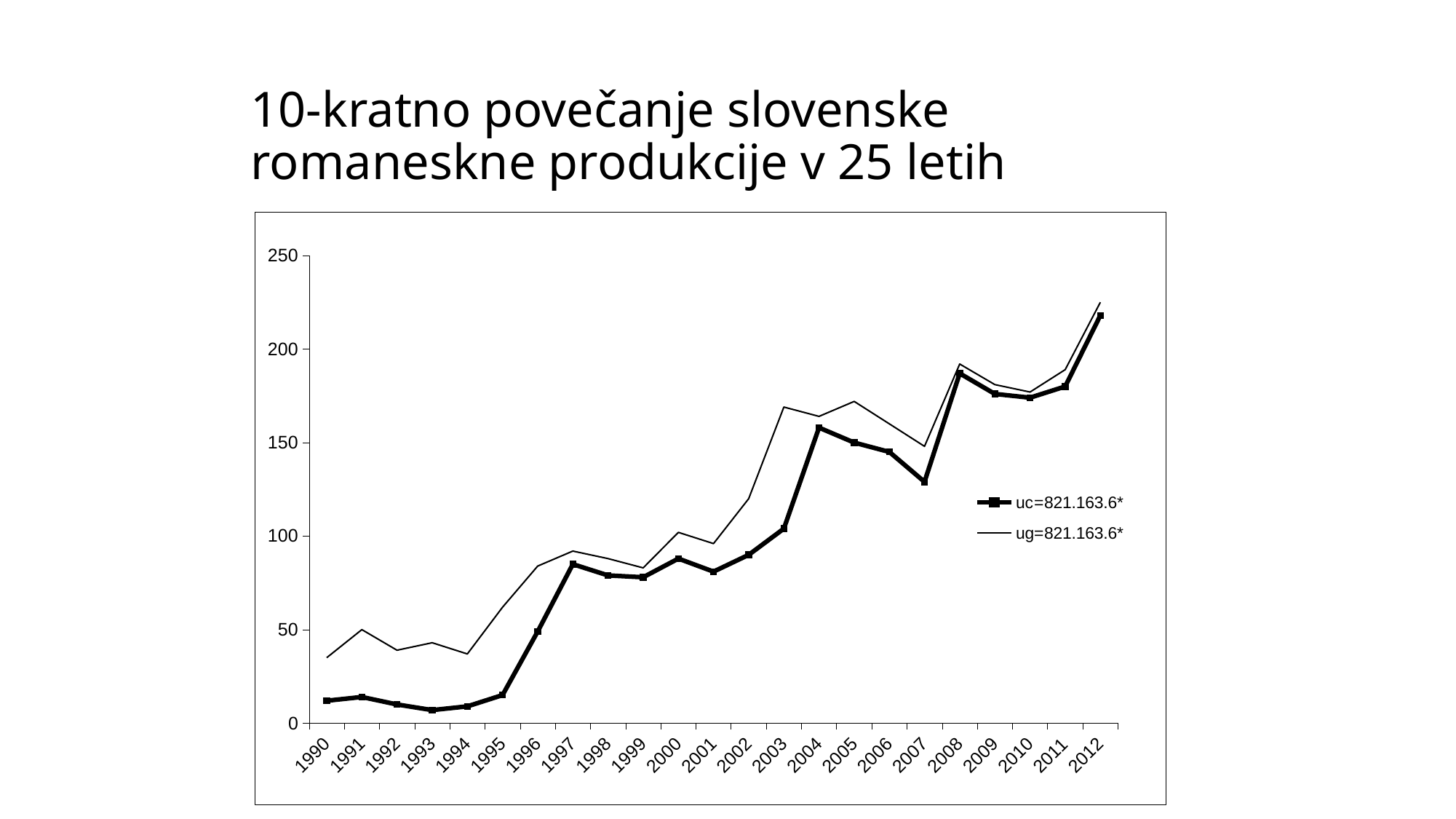
Is the value for uc=821.163.6* in 2007 greater or less than 150? less In which year does the ug=821.163.6* series reach its highest value? 2012 In which year does the uc=821.163.6* series reach its highest value? 2012 In which year does the uc=821.163.6* series reach its lowest value? 1993 Is the value for ug=821.163.6* in 2003 greater or less than 150? greater In 2003, which series has the higher value, uc=821.163.6* or ug=821.163.6*? ug=821.163.6* What kind of chart is shown on the slide? line chart Is the value for ug=821.163.6* in 1990 greater or less than 50? less How many years are plotted along the x axis? 23 How many series does the legend list? 2 Do the values of the uc=821.163.6* series generally rise or fall from 1990 to 2012? rise